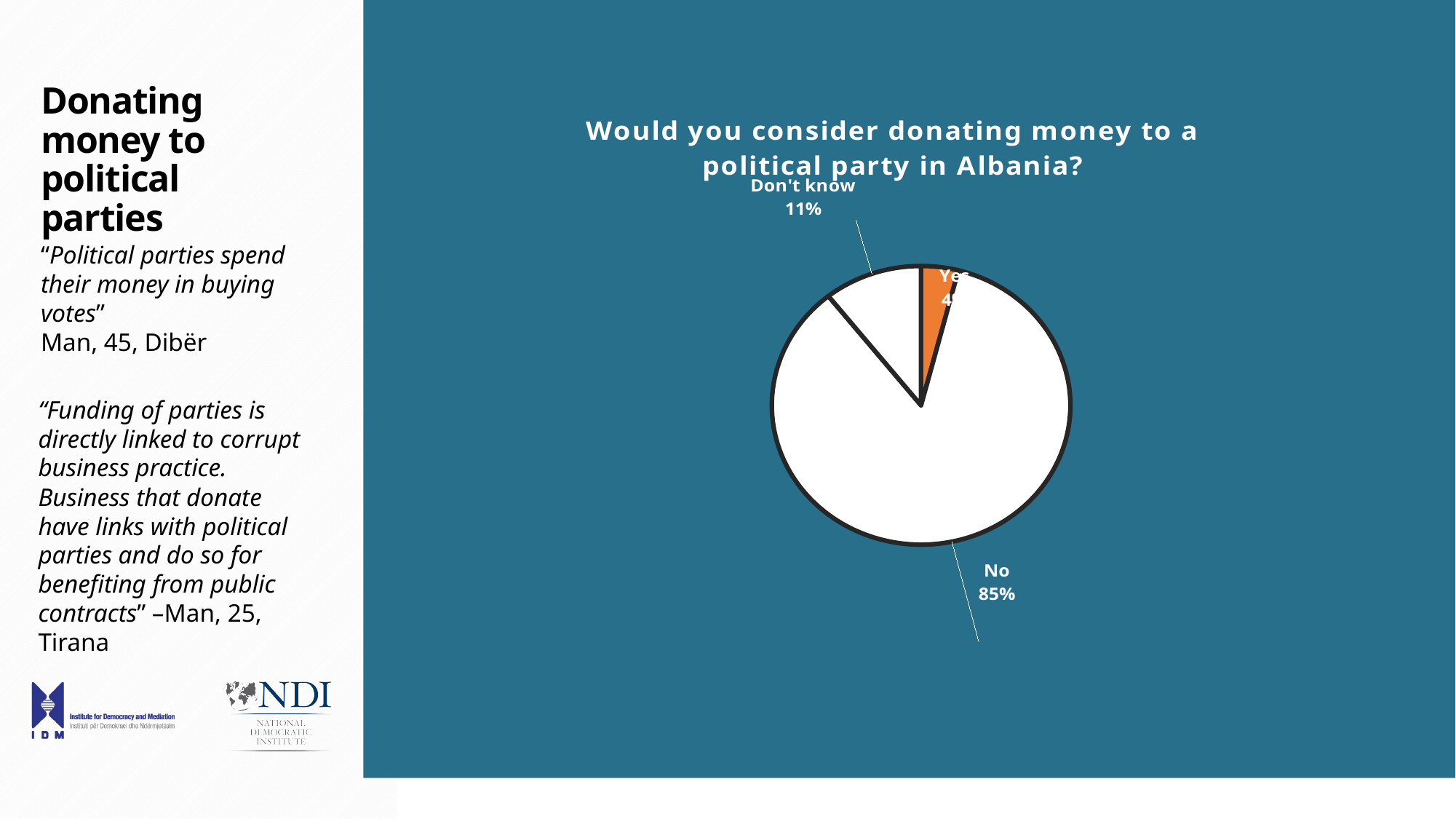
What percentage of respondents answered "Don't know"? 11% How many slices does the pie chart have? 3 What kind of chart is shown on the slide? Pie chart Which response has the largest share of the pie? No Which is larger, the share for "Don't know" or the share for "Yes"? Don't know Which response has the smallest share of the pie? Yes What is the difference in percentage points between the "No" and "Don't know" responses? 74 percentage points What percentage of respondents answered "No"? 85% What is the title of the chart? Would you consider donating money to a political party in Albania? What colour is the "Yes" slice of the pie? Orange What share of the pie does the "No" slice represent? 85%